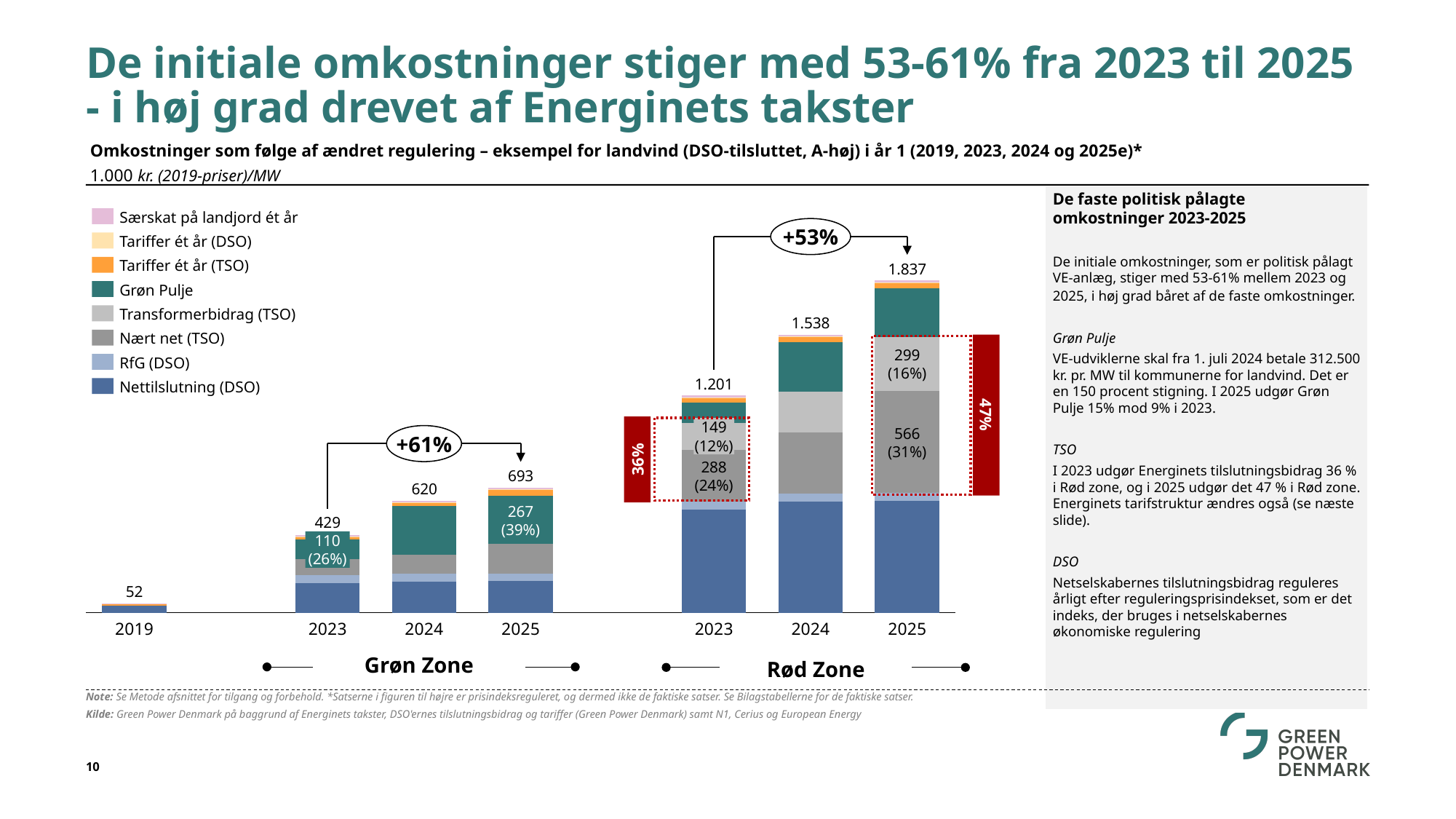
What is the total cost shown for 2024 in Grøn Zone? 620 What kind of chart is shown? Stacked bar chart Which is larger: the 2024 total in Rød Zone or the 2025 total in Grøn Zone? 2024 Rød Zone Which bar has the lowest total? 2019 How many series does the legend list? 8 What is the total cost shown for 2025 in Rød Zone? 1.837 What is the Nært net (TSO) value for 2025 in Rød Zone? 566 What is the Grøn Pulje value for 2025 in Grøn Zone? 267 What percentage increase is shown between 2023 and 2025 in Rød Zone? +53% What is the difference between the 2025 and 2023 totals in Grøn Zone? 264 Which bar has the highest total? 2025 Rød Zone What is the total cost shown for 2019? 52